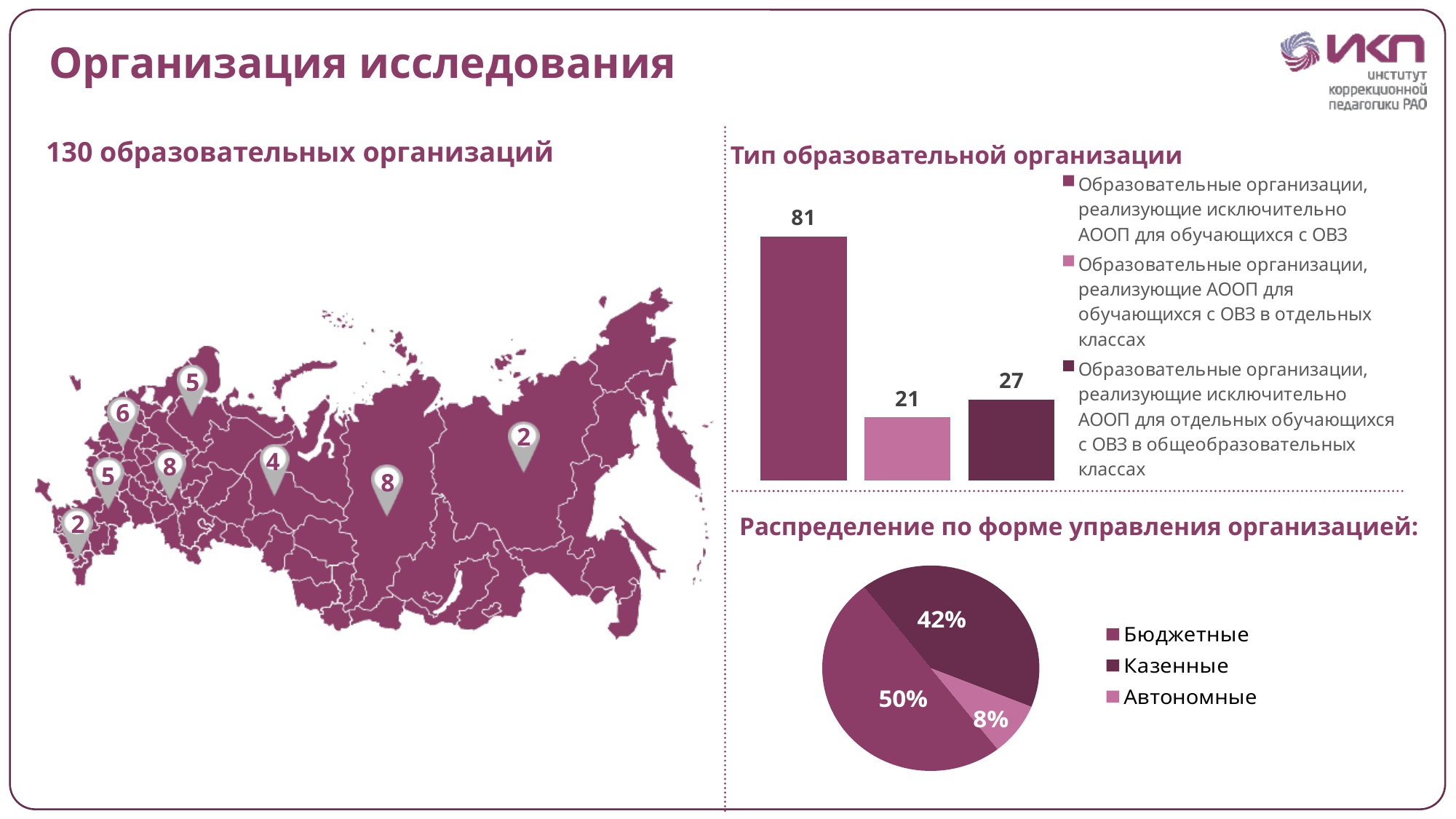
In the chart 'Тип образовательной организации', what is the difference between the highest bar (81) and the lowest bar (21)? 60 In the chart 'Тип образовательной организации', which category has the lowest value? Образовательные организации, реализующие АООП для обучающихся с ОВЗ в отдельных классах In the chart 'Тип образовательной организации', what is the value for 'Образовательные организации, реализующие исключительно АООП для обучающихся с ОВЗ'? 81 In the chart 'Тип образовательной организации', what is the value for 'Образовательные организации, реализующие АООП для обучающихся с ОВЗ в отдельных классах'? 21 In the chart 'Тип образовательной организации', what is the value for 'Образовательные организации, реализующие исключительно АООП для отдельных обучающихся с ОВЗ в общеобразовательных классах'? 27 In the pie chart 'Распределение по форме управления организацией', what share is 'Автономные'? 8% What kind of chart is 'Тип образовательной организации'? Bar chart In the pie chart 'Распределение по форме управления организацией', which is larger: 'Казенные' or 'Автономные'? Казенные In the chart 'Тип образовательной организации', which category has the highest value? Образовательные организации, реализующие исключительно АООП для обучающихся с ОВЗ How many entries does the legend of the pie chart 'Распределение по форме управления организацией' list? 3 In the pie chart 'Распределение по форме управления организацией', what share is 'Бюджетные'? 50% In the chart 'Тип образовательной организации', how many bars are plotted? 3